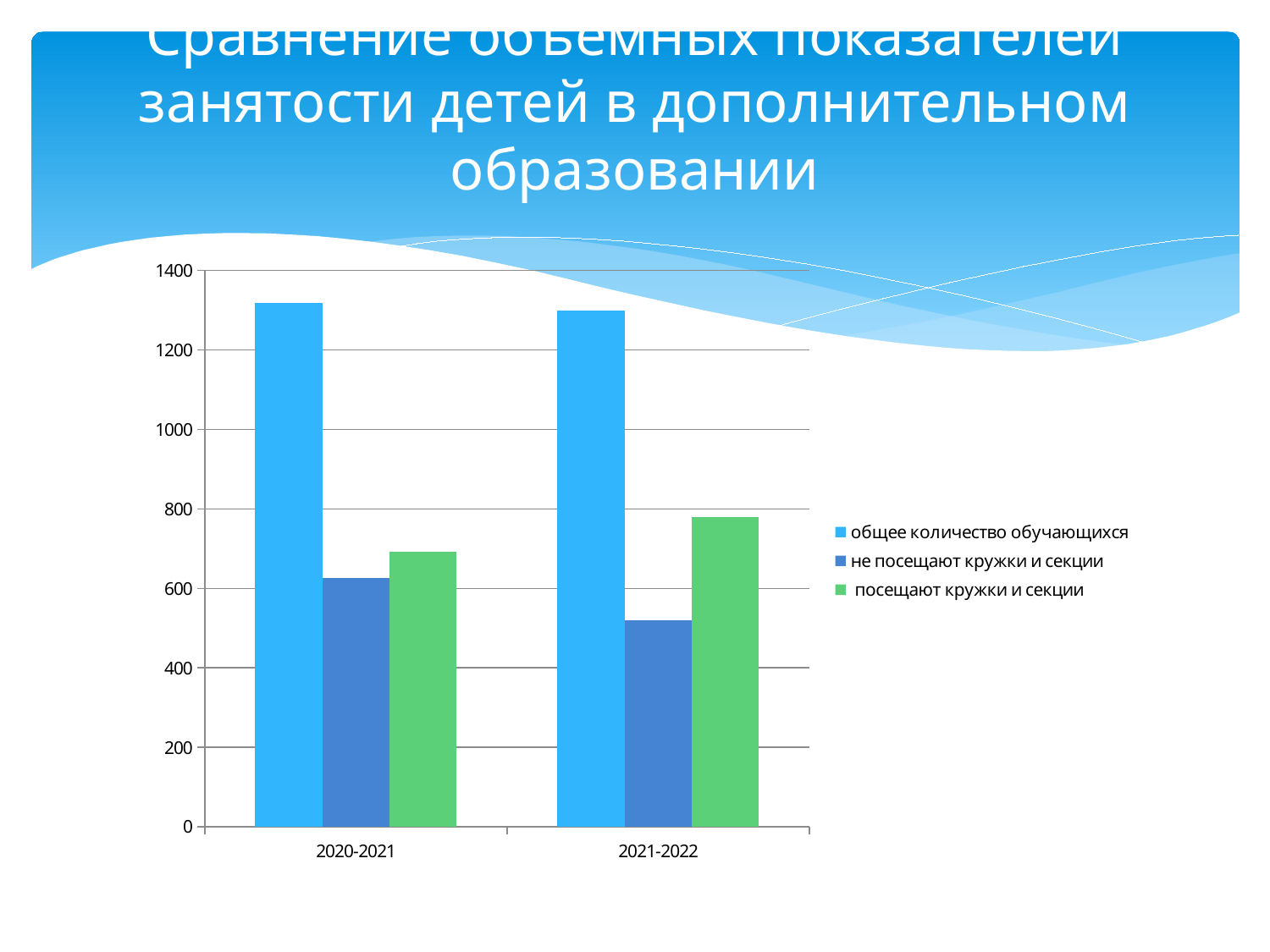
In 2021-2022, which is larger: 'не посещают кружки и секции' or 'посещают кружки и секции'? посещают кружки и секции Is the value for 'общее количество обучающихся' in 2020-2021 greater or less than 1200? greater How many series does the legend list? 3 Is the value for 'посещают кружки и секции' in 2021-2022 greater or less than 800? less How many categories are shown on the x axis of the chart? 2 What kind of chart is shown on the slide? bar chart Does the value for 'не посещают кружки и секции' rise or fall from 2020-2021 to 2021-2022? fall Is the value for 'не посещают кружки и секции' in 2021-2022 greater or less than 600? less Does the value for 'посещают кружки и секции' rise or fall from 2020-2021 to 2021-2022? rise Which series is shown in green in the legend? посещают кружки и секции Which series has the lowest value in 2021-2022? не посещают кружки и секции